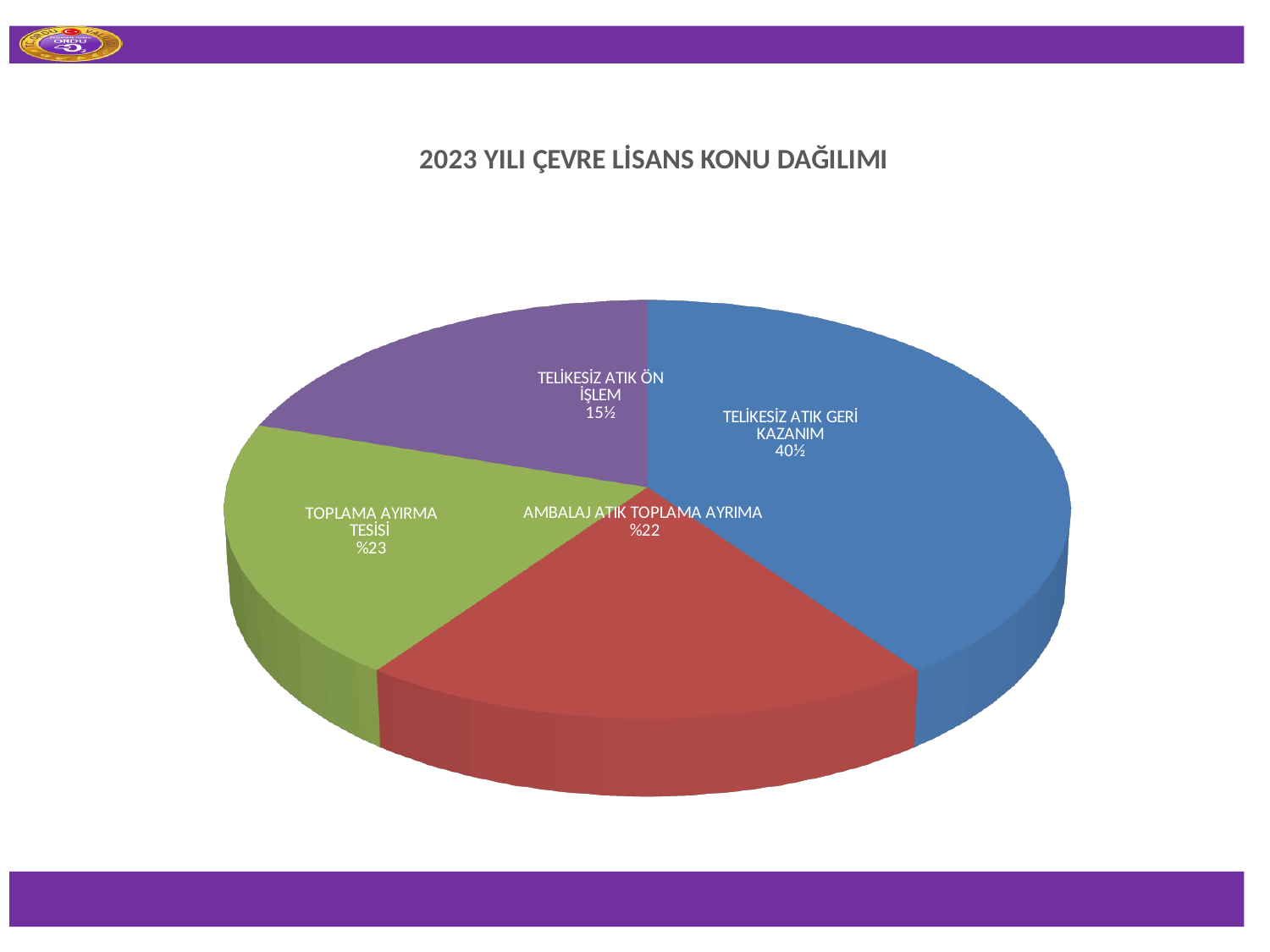
How many slices does the pie chart have? 4 Which slice is the largest in the pie chart? TELİKESİZ ATIK GERİ KAZANIM What kind of chart is shown on the slide? pie chart What is the title of the chart? 2023 YILI ÇEVRE LİSANS KONU DAĞILIMI What value is shown for the TELİKESİZ ATIK ÖN İŞLEM slice? 15½ Which is larger, the TOPLAMA AYIRMA TESİSİ slice or the TELİKESİZ ATIK ÖN İŞLEM slice? TOPLAMA AYIRMA TESİSİ What colour is the TELİKESİZ ATIK GERİ KAZANIM slice? blue What value is shown for the TOPLAMA AYIRMA TESİSİ slice? %23 Which slice is the smallest in the pie chart? TELİKESİZ ATIK ÖN İŞLEM What value is shown for the TELİKESİZ ATIK GERİ KAZANIM slice? 40½ What value is shown for the AMBALAJ ATIK TOPLAMA AYRIMA slice? %22 By how many percentage points does TOPLAMA AYIRMA TESİSİ exceed AMBALAJ ATIK TOPLAMA AYRIMA? 1